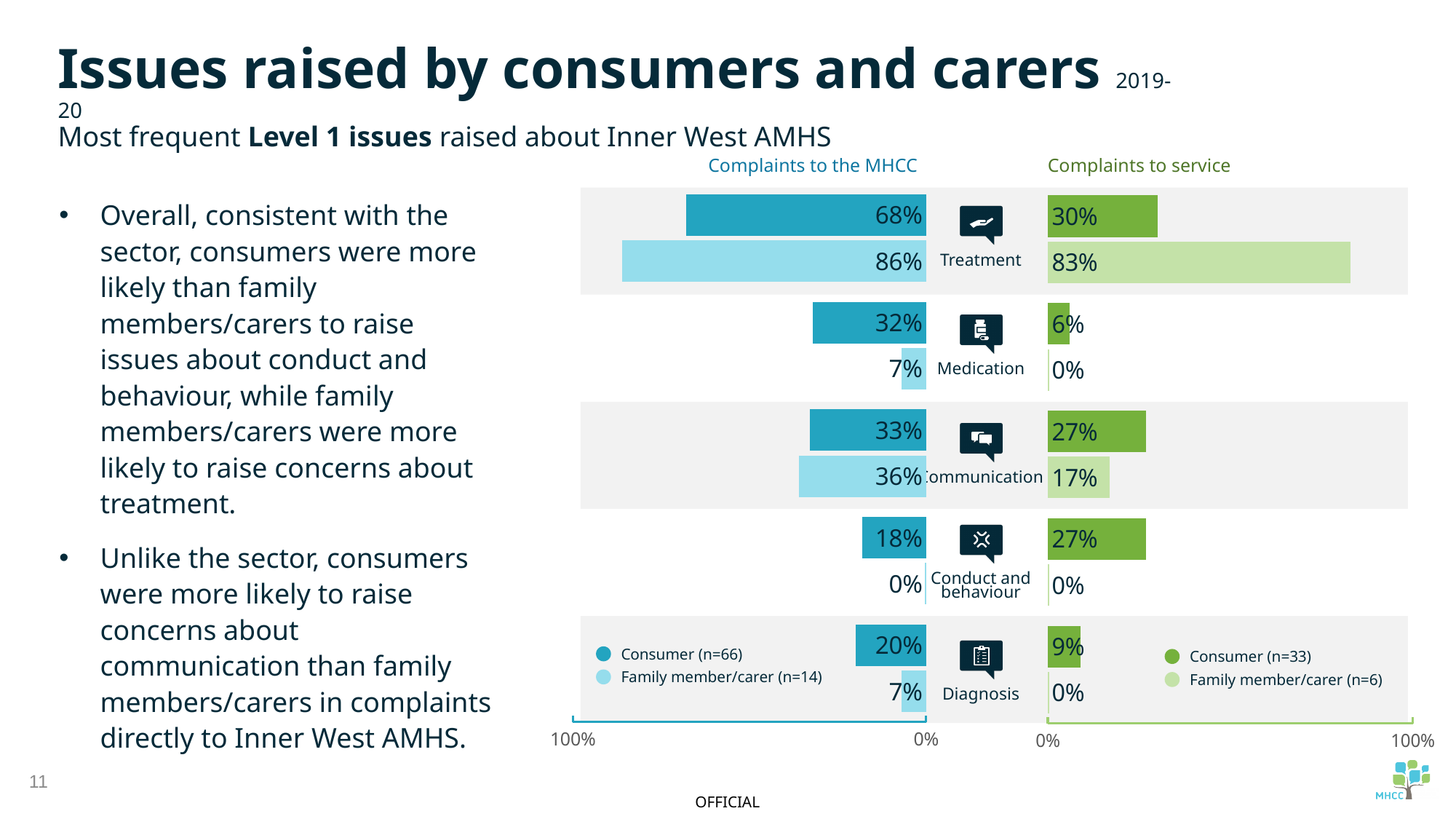
In the 'Complaints to service' chart, which issue has the lowest percentage for consumers? Medication In the 'Complaints to the MHCC' chart, what percentage of consumers raised issues about Treatment? 68% In the 'Complaints to the MHCC' chart, which is larger for Medication: the consumer percentage or the family member/carer percentage? Consumer In the 'Complaints to the MHCC' chart, what percentage of family members/carers raised issues about Treatment? 86% In the 'Complaints to service' chart, what percentage of family members/carers raised issues about Treatment? 83% In the 'Complaints to the MHCC' chart, which issue has the highest percentage for consumers? Treatment According to the legend of the 'Complaints to the MHCC' chart, how many consumers are in the sample? n=66 How many series does the legend of the 'Complaints to service' chart list? 2 In the 'Complaints to the MHCC' chart, what is the difference between the family member/carer and consumer percentages for Treatment? 18% How many issue categories are shown in the charts? 5 In the 'Complaints to service' chart, what percentage of consumers raised issues about Conduct and behaviour? 27% What type of chart is used to show the complaints data? Bar chart